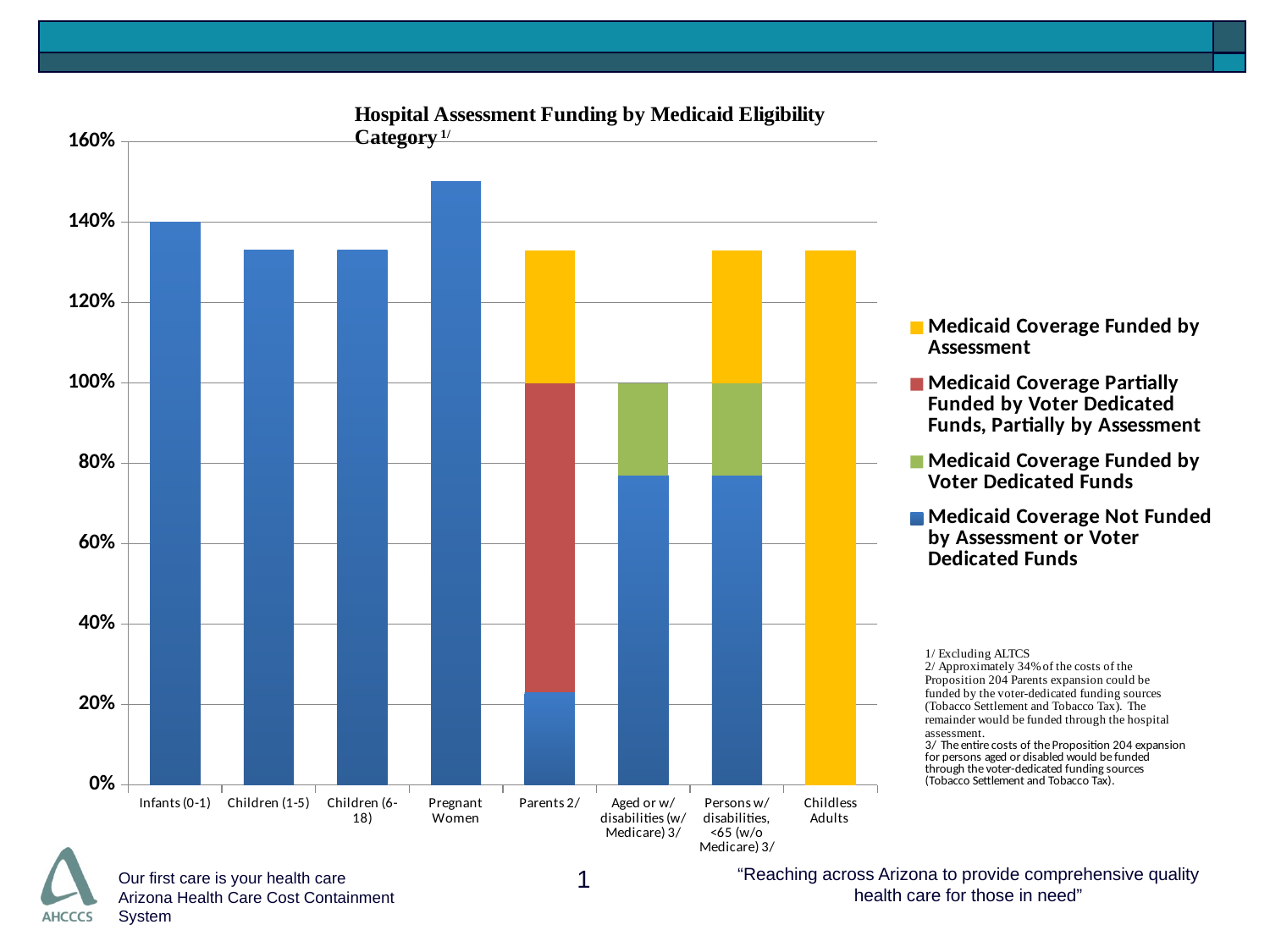
Is the total bar height for Pregnant Women greater or less than 140%? greater Which category has the tallest bar overall? Pregnant Women How many series does the legend list? 4 What value does the bar for Infants (0-1) reach on the y axis? 140% Which bar is taller: Infants (0-1) or Children (1-5)? Infants (0-1) Is the total bar height for 'Aged or w/ disabilities (w/ Medicare) 3/' greater or less than 120%? less Which series is shown in yellow in the legend? Medicaid Coverage Funded by Assessment How many Medicaid eligibility categories are shown on the x axis? 8 Is the 'Medicaid Coverage Not Funded by Assessment or Voter Dedicated Funds' segment for Parents 2/ greater or less than 40%? less What kind of chart is shown on the slide? bar chart What is the title of the chart? Hospital Assessment Funding by Medicaid Eligibility Category 1/